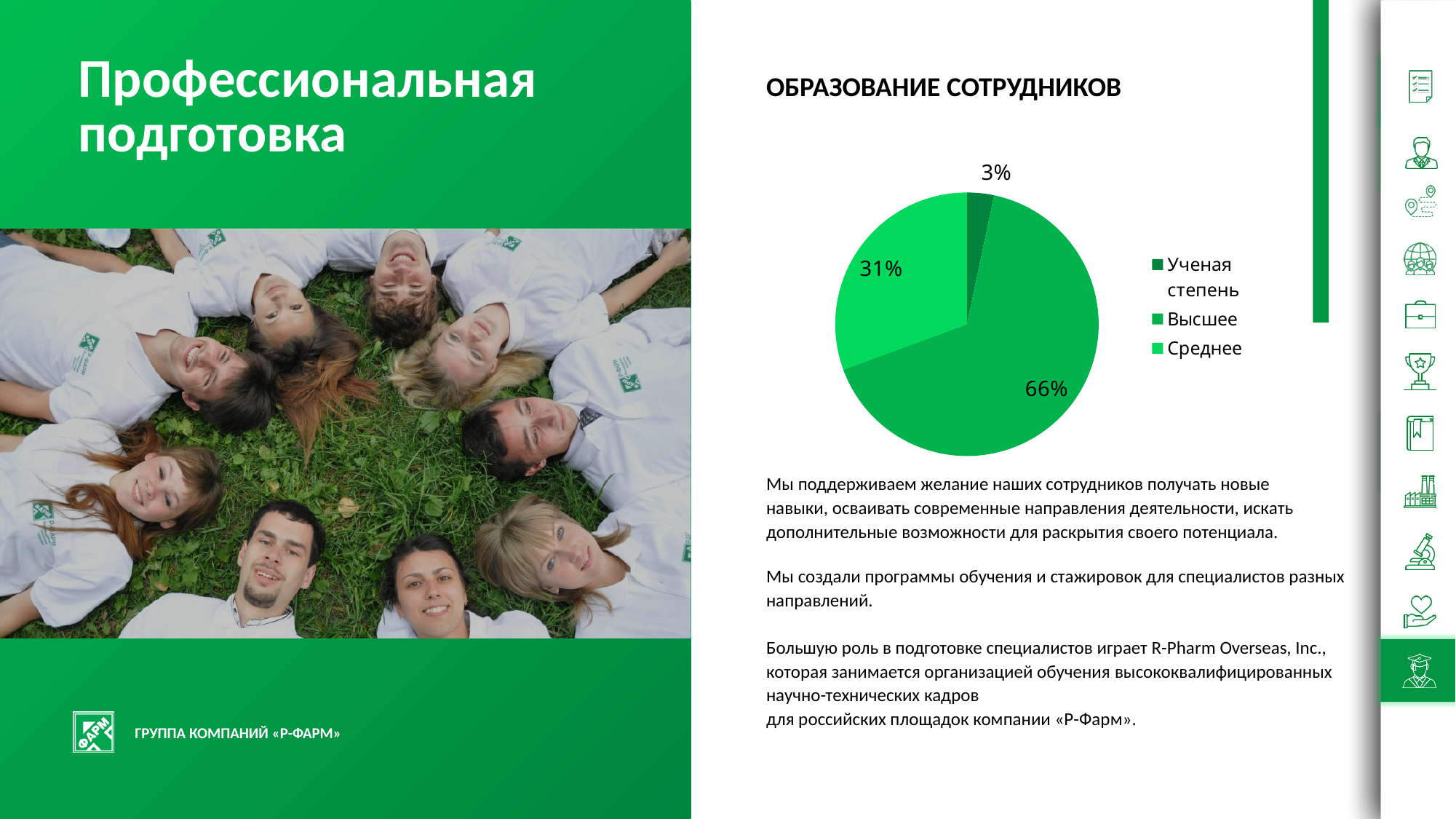
How many slices does the pie chart have? 3 How many entries does the legend list? 3 What share of employees have secondary education (Среднее)? 31% Which education category has the smallest share of the pie? Ученая степень What type of chart is shown on the slide? Pie chart What is the combined share of Среднее and Ученая степень? 34% What is the title of the chart? ОБРАЗОВАНИЕ СОТРУДНИКОВ What is the difference in percentage points between Высшее and Среднее? 35 What share of employees have an academic degree (Ученая степень)? 3% Which education category has the largest share of the pie? Высшее What share of employees have higher education (Высшее)? 66% Which is larger, the share for Среднее or the share for Ученая степень? Среднее